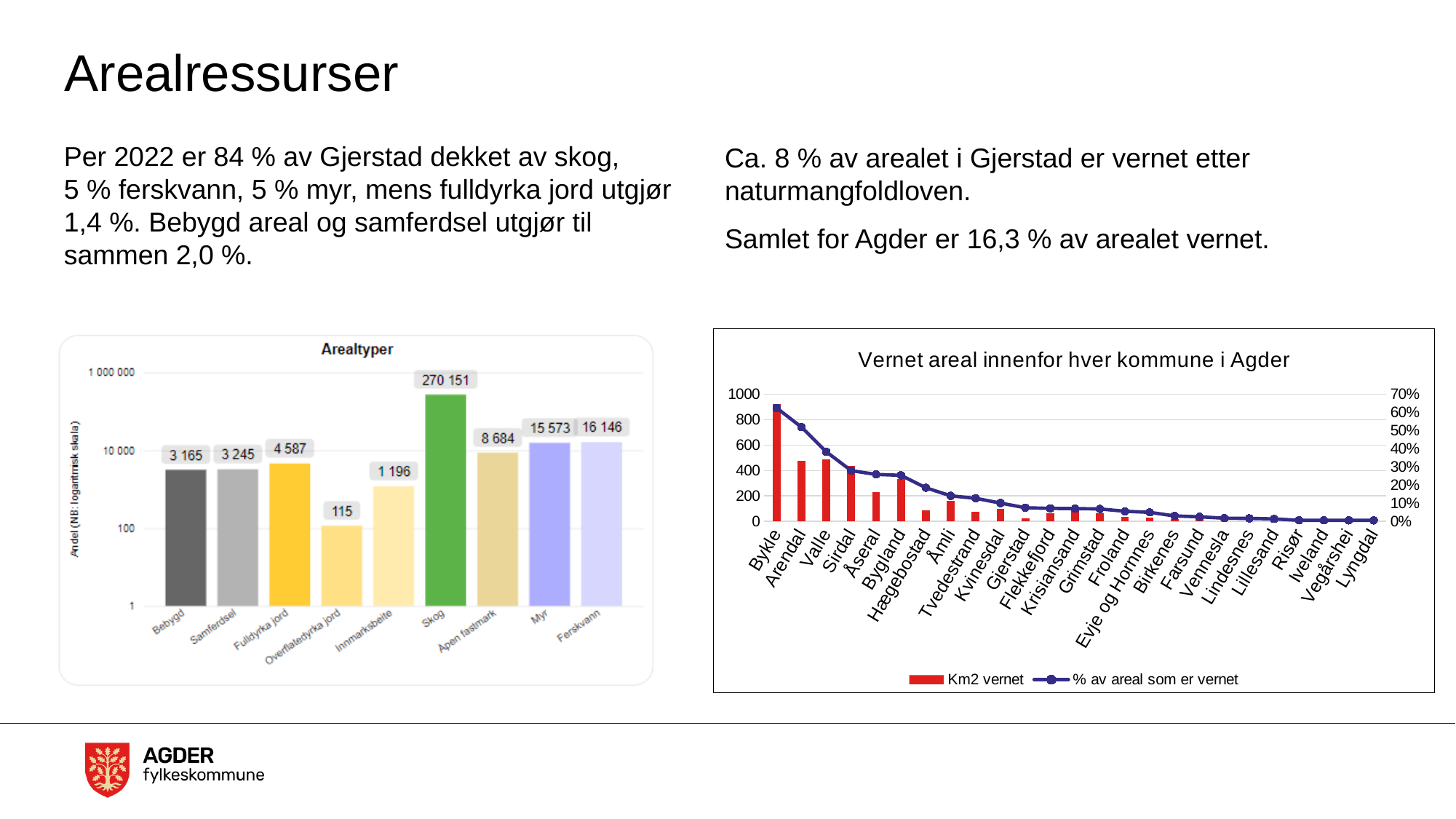
In the chart 'Vernet areal innenfor hver kommune i Agder', which municipality has the highest Km2 vernet? Bykle In the Arealtyper chart, which is larger, Bebygd or Samferdsel? Samferdsel In the Arealtyper chart, which category has the lowest value? Overflatedyrka jord In the chart 'Vernet areal innenfor hver kommune i Agder', is the Km2 vernet value for Bykle greater or less than 800? greater In the Arealtyper chart, what is the value for Overflatedyrka jord? 115 How many series does the legend of the chart 'Vernet areal innenfor hver kommune i Agder' list? 2 In the Arealtyper chart, which category has the highest value? Skog In the chart 'Vernet areal innenfor hver kommune i Agder', is the Km2 vernet value for Arendal greater or less than 600? less In the Arealtyper chart, what is the value for Ferskvann? 16 146 How many categories are shown in the Arealtyper chart? 9 In the Arealtyper chart, what is the value for Skog? 270 151 In the Arealtyper chart, what is the difference between Ferskvann and Myr? 573